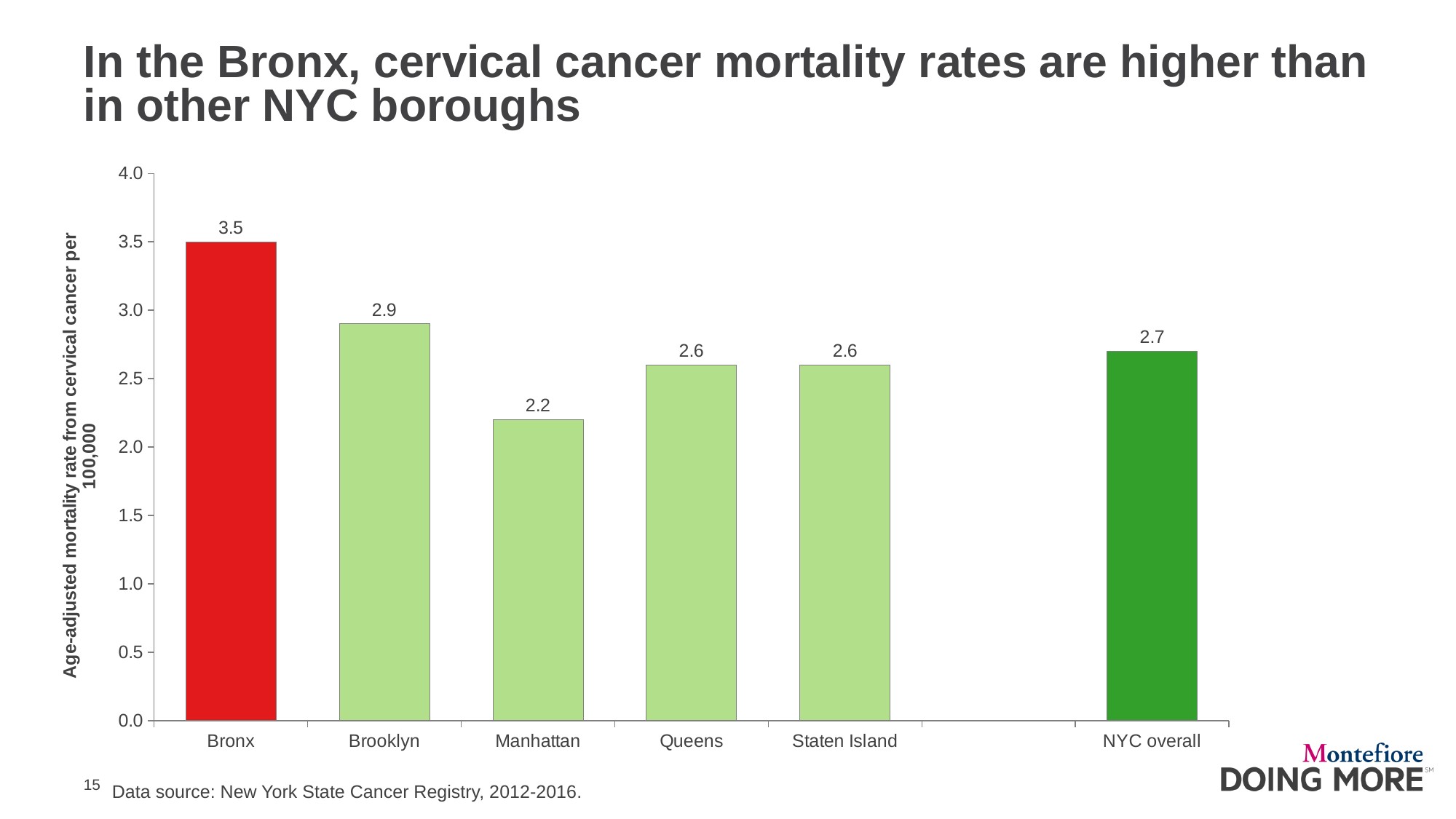
Which borough has the highest cervical cancer mortality rate? Bronx Is the value for the Bronx greater or less than 3.0? greater What is the age-adjusted cervical cancer mortality rate for the Bronx? 3.5 What is the value shown for NYC overall? 2.7 Which borough has the lowest cervical cancer mortality rate? Manhattan What is the age-adjusted cervical cancer mortality rate for Manhattan? 2.2 Which has a higher mortality rate, Brooklyn or Queens? Brooklyn How many bars are plotted on the chart? 6 What is the difference between the Bronx rate and the NYC overall rate? 0.8 Which bar is coloured red? Bronx What is the difference between the Brooklyn rate and the Manhattan rate? 0.7 What kind of chart is shown on the slide? Bar chart